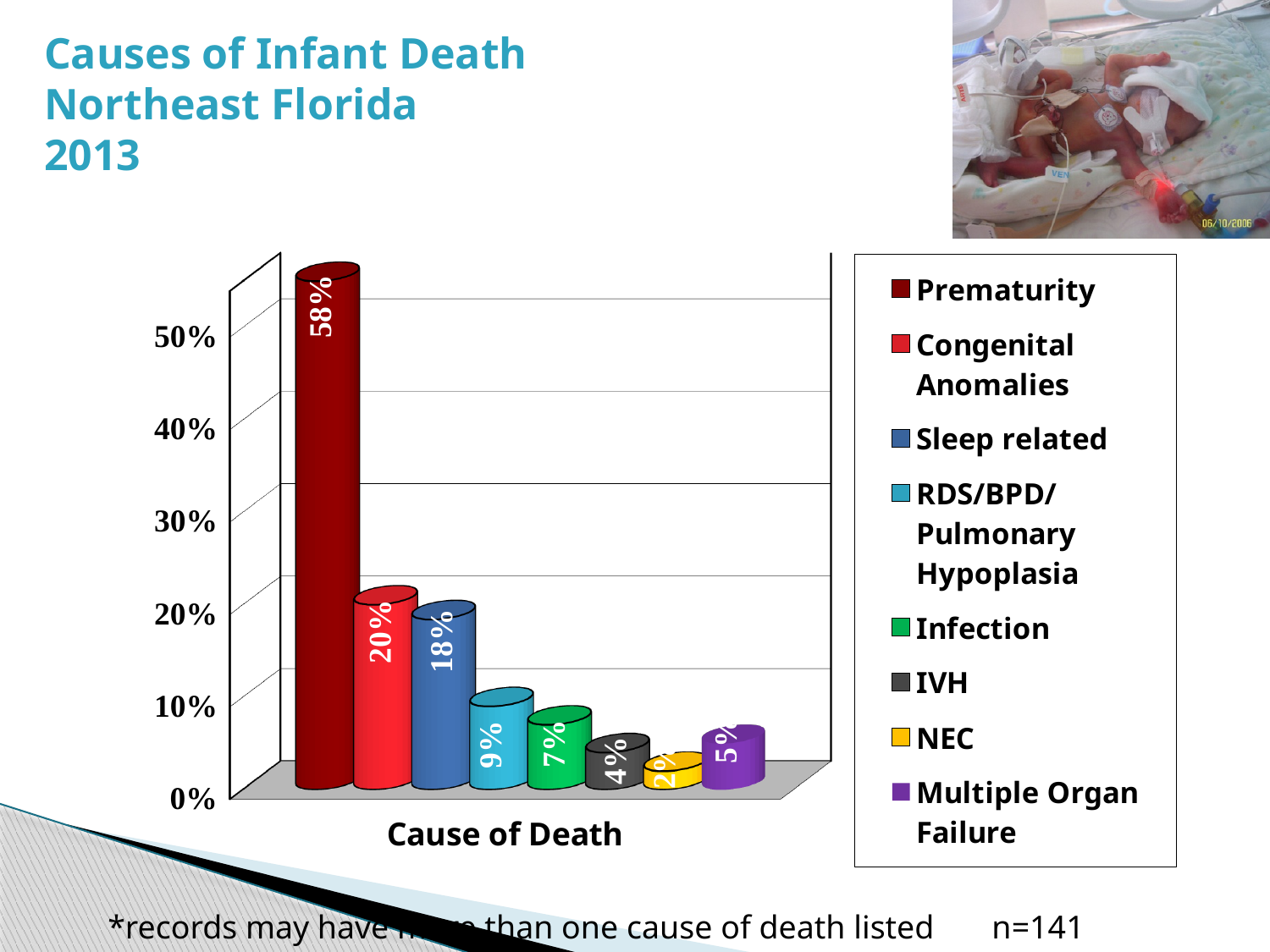
What is the value for Infection? 7% What is the difference between the values for Prematurity and Congenital Anomalies? 38% Which is larger, the value for IVH or the value for Multiple Organ Failure? Multiple Organ Failure What is the value for Sleep related? 18% What is the value for Multiple Organ Failure? 5% Which cause of death has the lowest value? NEC Which cause of death has the highest value? Prematurity What is the x-axis title of the chart? Cause of Death How many causes of death are plotted in the chart? 8 What is the value for Congenital Anomalies? 20% What kind of chart is shown on the slide? Bar chart What is the value for Prematurity? 58%